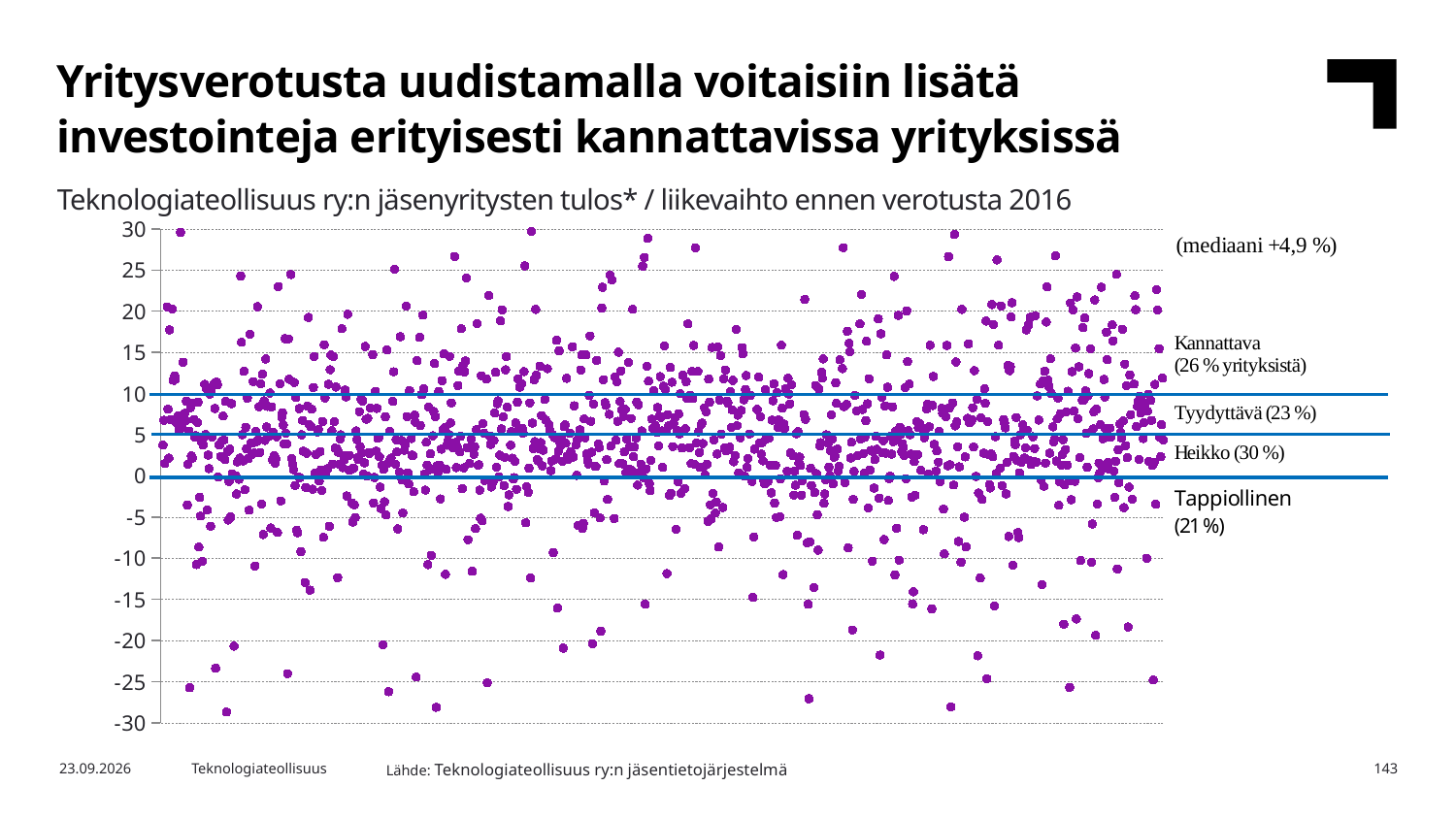
What kind of chart is shown on the slide? Scatter chart Which year does the chart's data refer to? 2016 What share of companies falls into the Kannattava category? 26 % What is the median value of tulos / liikevaihto shown on the chart? +4,9 % How many percentage points larger is the Heikko share than the Tappiollinen share? 9 percentage points What share of companies falls into the Heikko category? 30 % Which category has a larger share of companies, Kannattava or Tyydyttävä? Kannattava Which category has the largest share of companies? Heikko What share of companies falls into the Tappiollinen category? 21 % What is the highest value shown on the vertical axis? 30 Which category has the smallest share of companies? Tappiollinen What share of companies falls into the Tyydyttävä category? 23 %